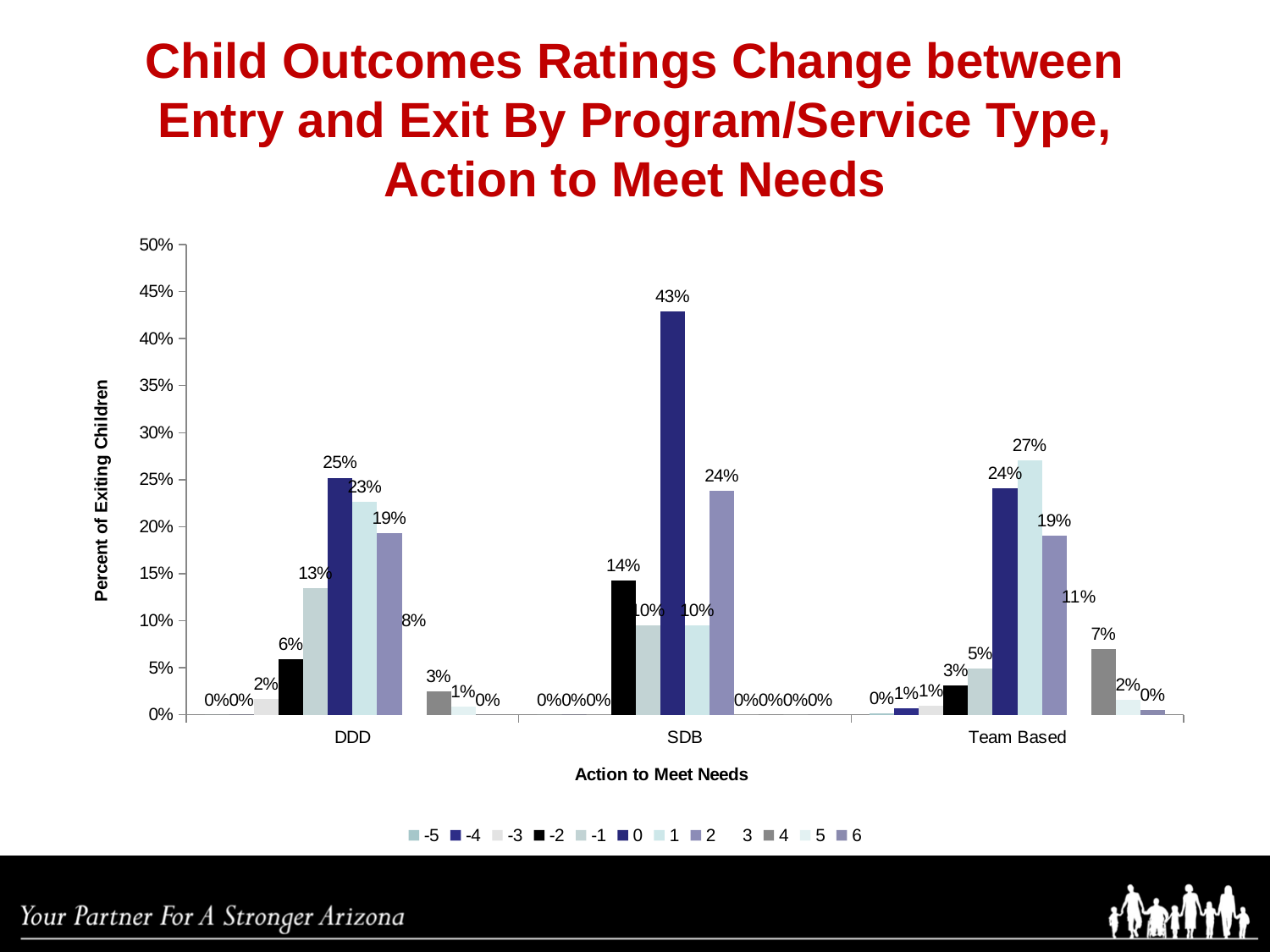
What is the value for the -1 series in the DDD category? 13% What type of chart is shown on the slide? Bar chart How many program/service type categories are shown on the x axis? 3 Which is larger: the 2 series value for SDB or the 2 series value for DDD? SDB What is the title of the y axis? Percent of Exiting Children What is the value for the 0 series in the SDB category? 43% How many series does the legend list? 12 What is the difference between the 0 series value for SDB and the 0 series value for DDD? 18 percentage points Is the value for the 0 series in the SDB category greater or less than 40%? greater Which category contains the tallest bar in the chart? SDB What is the value for the 1 series in the Team Based category? 27% What is the value for the -2 series in the SDB category? 14%